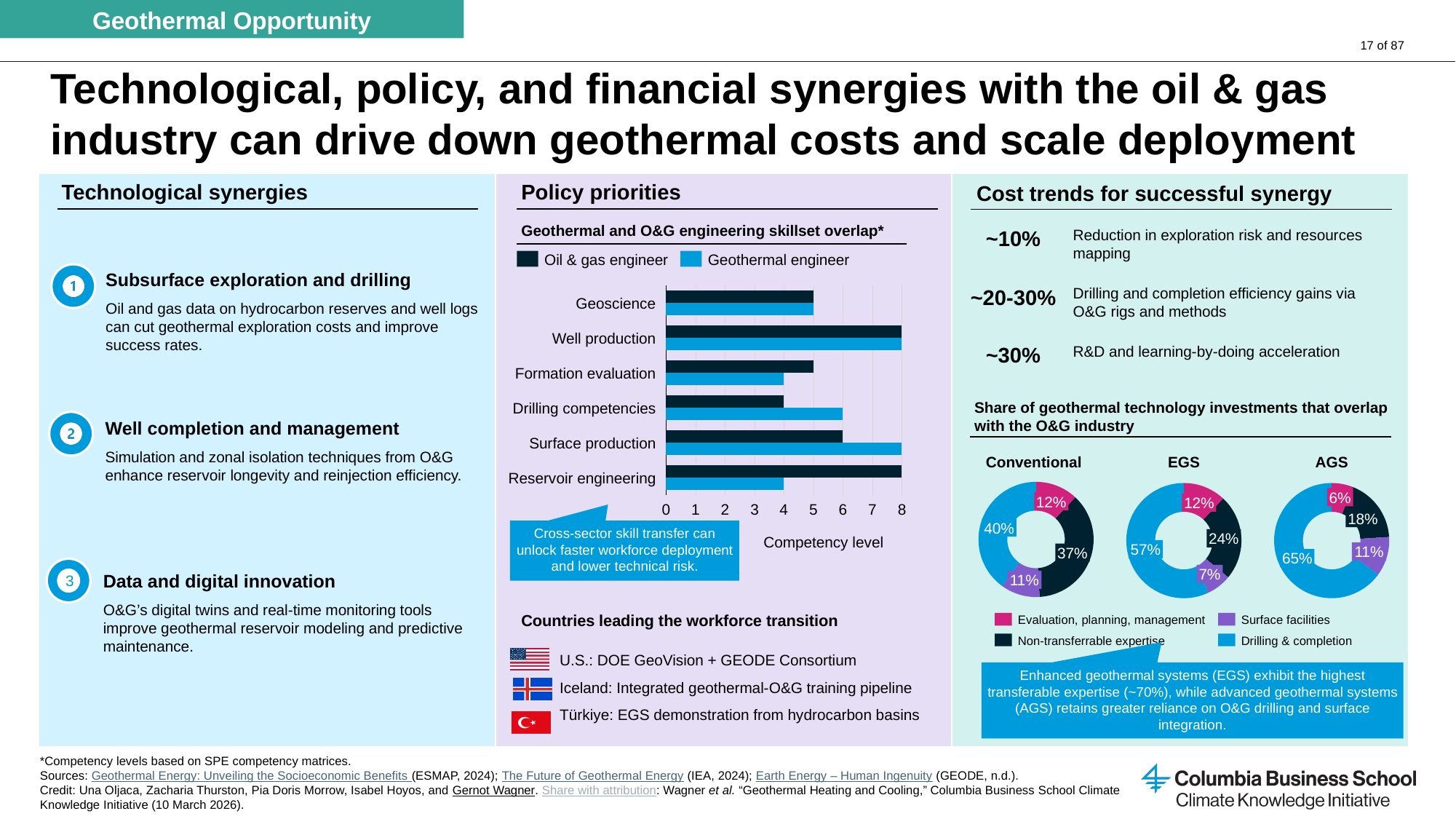
In the 'Geothermal and O&G engineering skillset overlap' chart, what is the competency level for Geothermal engineer in Drilling competencies? 6 In the 'Geothermal and O&G engineering skillset overlap' chart, what is the difference between the Oil & gas engineer and Geothermal engineer competency levels for Reservoir engineering? 4 In the Conventional donut chart, what share is Drilling & completion? 40% In the 'Geothermal and O&G engineering skillset overlap' chart, which category has the lowest Oil & gas engineer competency level? Drilling competencies In the EGS donut chart, what share is Non-transferable expertise? 24% In the 'Geothermal and O&G engineering skillset overlap' chart, what is the competency level for Oil & gas engineer in Reservoir engineering? 8 In the 'Geothermal and O&G engineering skillset overlap' chart, which is larger for Surface production: Oil & gas engineer or Geothermal engineer? Geothermal engineer What is the difference between the Drilling & completion share in the AGS donut chart and in the Conventional donut chart? 25% What kind of chart is the 'Geothermal and O&G engineering skillset overlap' chart? Bar chart In the AGS donut chart, which segment is the largest? Drilling & completion In the 'Geothermal and O&G engineering skillset overlap' chart, how many competency categories are plotted? 6 In the 'Geothermal and O&G engineering skillset overlap' bar chart, how many series does the legend list? 2